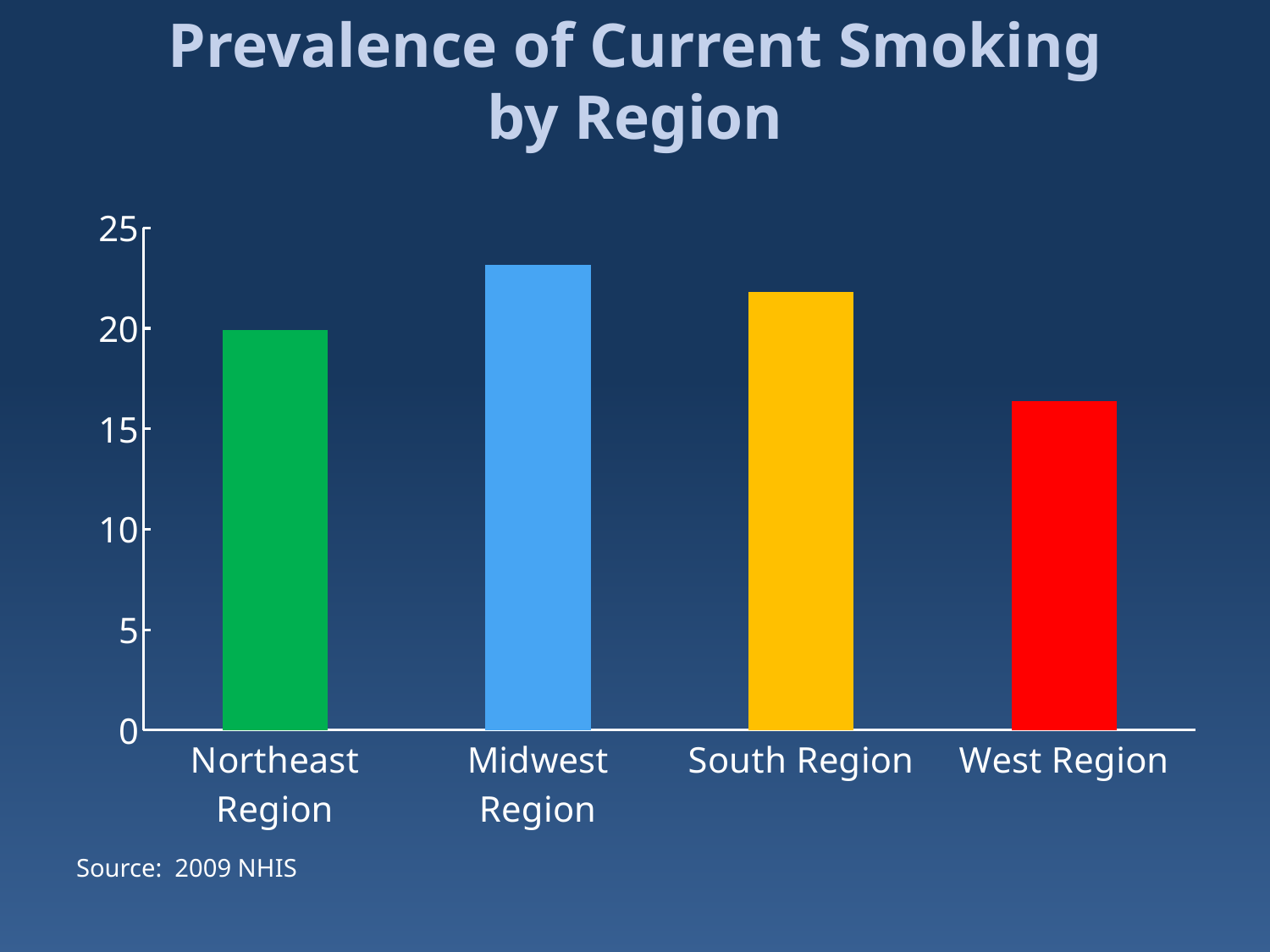
Which region has the lowest prevalence of current smoking? West Region Is the value for the West Region greater or less than 15? greater Is the value for the South Region greater or less than 20? greater Which region has the highest prevalence of current smoking? Midwest Region Which has a higher value, the Northeast Region or the West Region? Northeast Region Which has a higher value, the Midwest Region or the South Region? Midwest Region How many regions are shown on the chart? 4 What kind of chart is shown on the slide? bar chart Is the value for the Midwest Region greater or less than 25? less What is the title of the chart? Prevalence of Current Smoking by Region